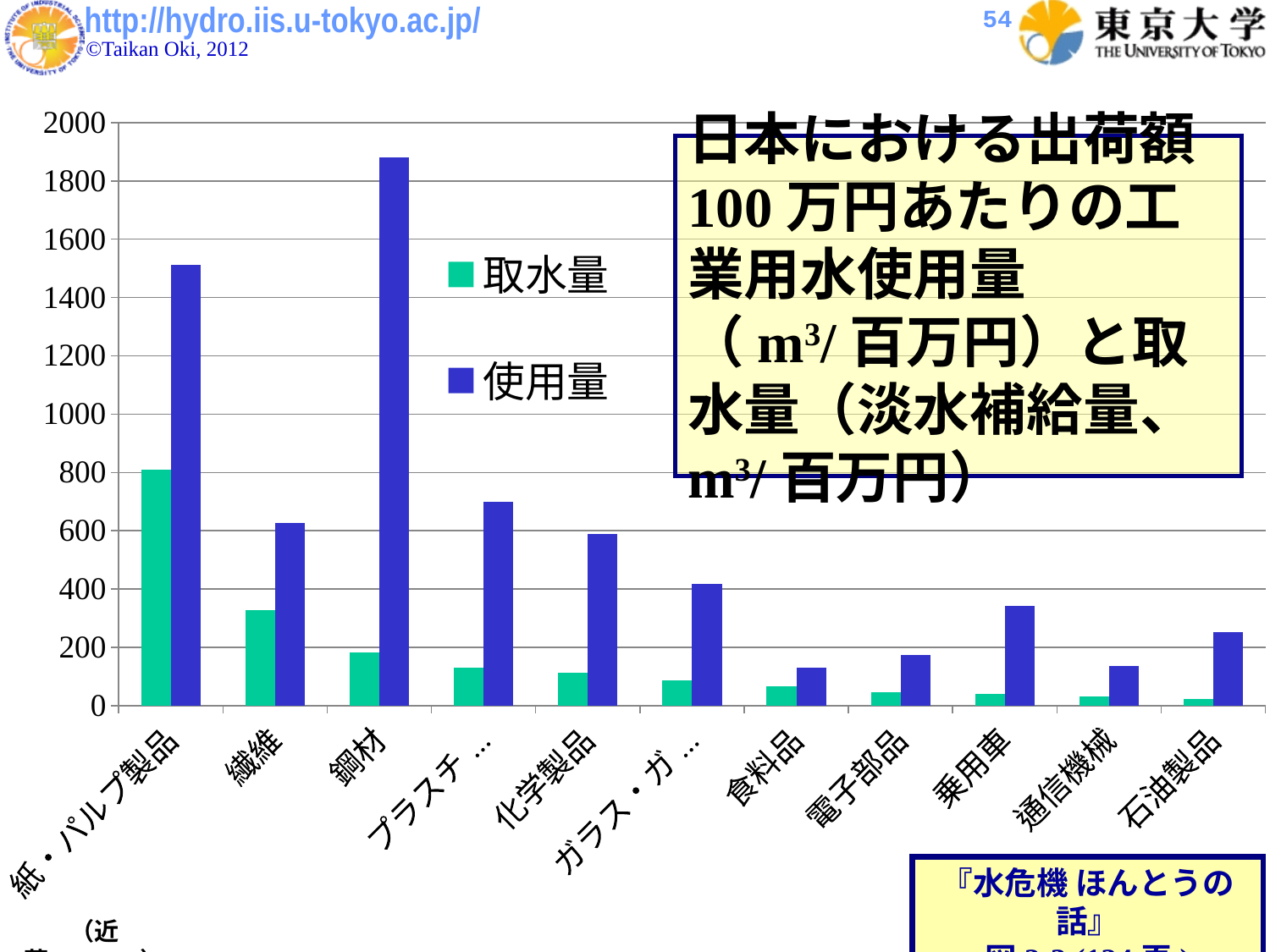
Is the 使用量 value for 繊維 greater or less than 400? greater What kind of chart is shown on the slide? bar chart Which is larger, the 使用量 value for 紙・パルプ製品 or for 鋼材? 鋼材 Which is larger, the 取水量 value for 繊維 or for 鋼材? 繊維 Is the 使用量 value for 乗用車 greater or less than 400? less Which category has the highest 取水量 value? 紙・パルプ製品 How many categories are shown on the x axis? 11 Is the 取水量 value for 紙・パルプ製品 greater or less than 600? greater How many series does the legend list? 2 Which category has the highest 使用量 value? 鋼材 Which colour represents the 取水量 series in the legend? green